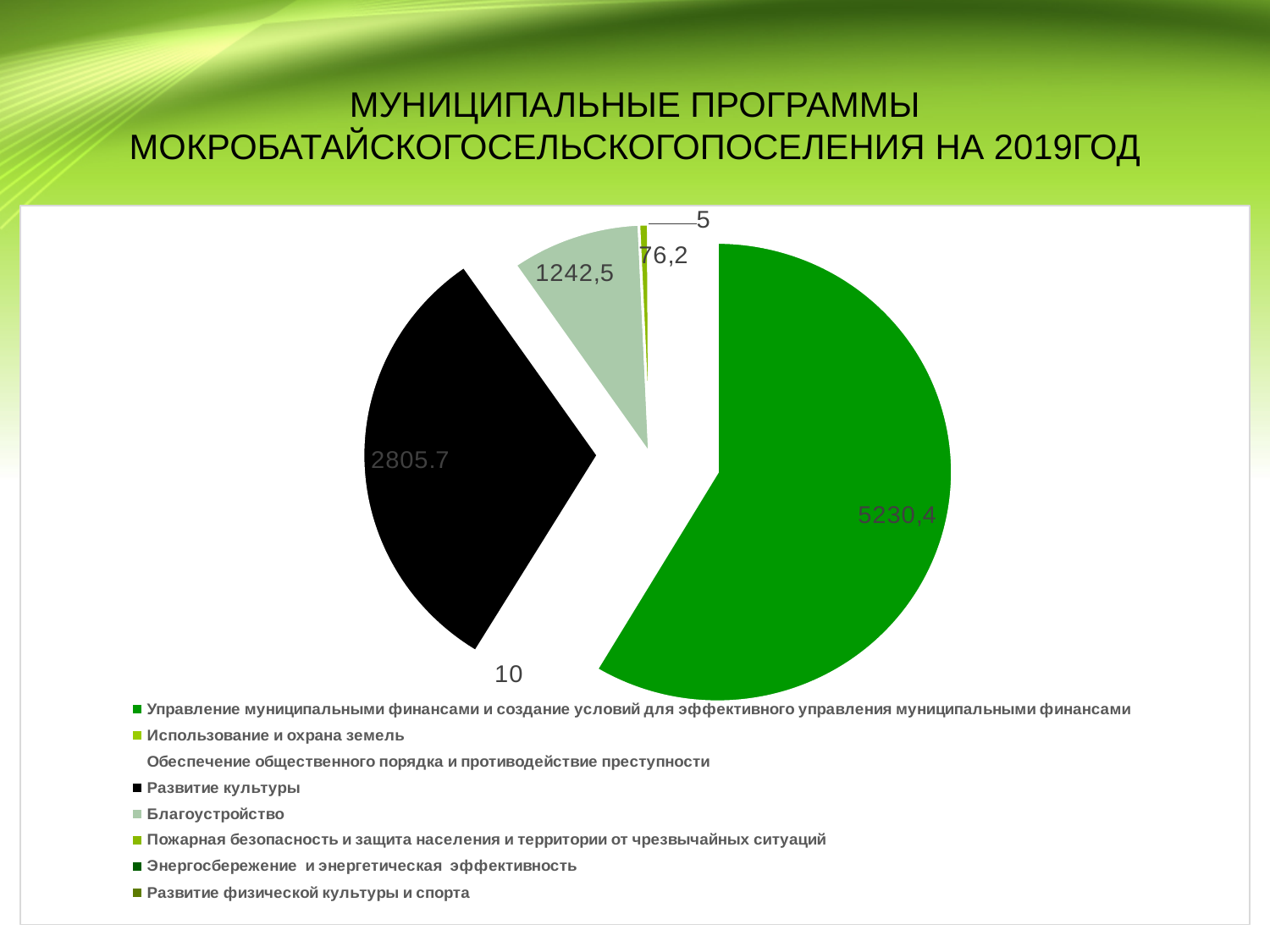
Which is larger, the value for 'Развитие культуры' or the value for 'Благоустройство'? Развитие культуры What value is shown for the slice 'Управление муниципальными финансами и создание условий для эффективного управления муниципальными финансами'? 5230,4 Which programme has the largest slice of the pie? Управление муниципальными финансами и создание условий для эффективного управления муниципальными финансами What kind of chart is shown on the slide? pie chart For which year does the slide title say the municipal programmes are? 2019 What colour is the largest slice of the pie? green How many entries does the legend of the pie chart list? 8 What value is shown for the 'Развитие культуры' slice? 2805.7 What value is shown for the 'Благоустройство' slice? 1242,5 Which is larger, the value for 'Управление муниципальными финансами' or the value for 'Развитие культуры'? Управление муниципальными финансами